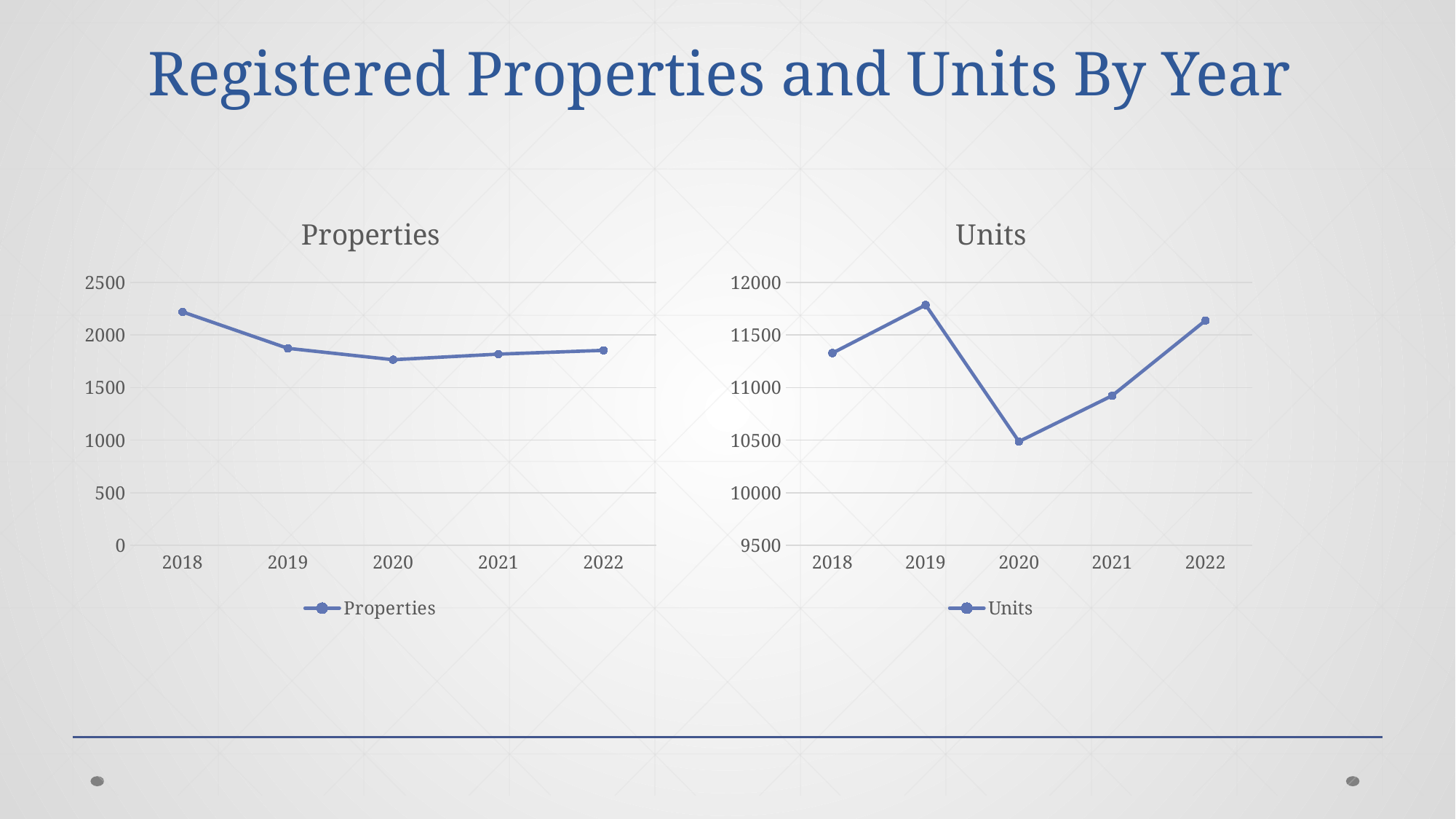
In the Properties chart, do the values rise or fall from 2018 to 2020? fall What is the title of the chart on the right side of the slide? Units How many series does the legend of the Properties chart list? 1 In the Units chart, which year has the lowest value? 2020 In the Properties chart, which year has the highest value? 2018 How many years are plotted on the Units chart? 5 In the Units chart, which year has the highest value? 2019 In the Properties chart, which year has the lowest value? 2020 In the Units chart, which is larger, the value for 2021 or the value for 2022? 2022 What kind of chart is the Properties chart? line chart In the Properties chart, is the value for 2018 greater or less than 2000? greater